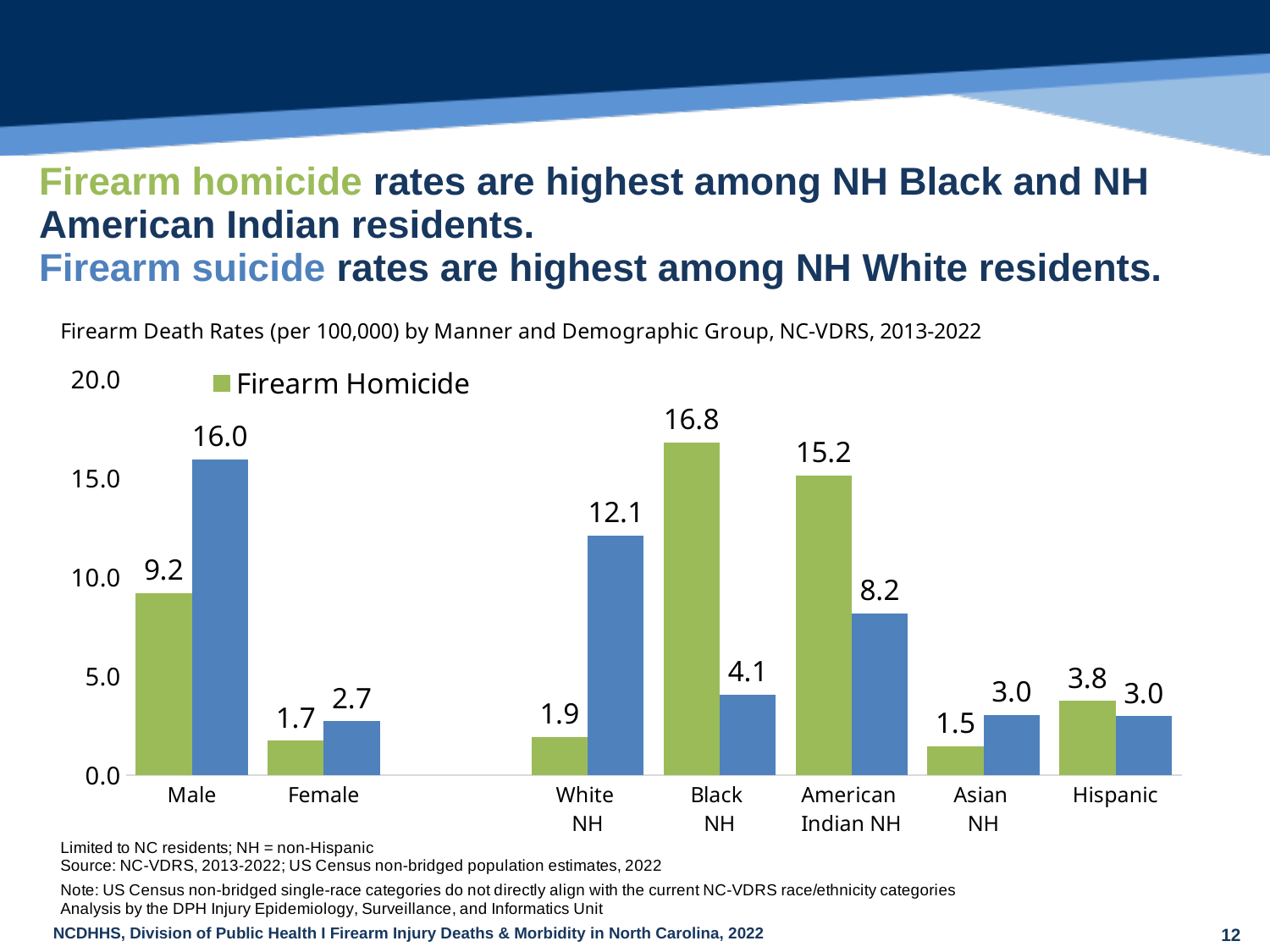
What is the firearm homicide rate for Black NH residents? 16.8 Which demographic group has the lowest firearm homicide rate? Asian NH What is the title of the chart? Firearm Death Rates (per 100,000) by Manner and Demographic Group, NC-VDRS, 2013-2022 How many demographic groups are shown on the x axis? 7 What is the value of the blue bar for Male? 16.0 Which is larger for Hispanic residents, the green bar or the blue bar? The green bar (3.8) What series name is shown in the chart legend? Firearm Homicide What is the firearm homicide rate for Female? 1.7 What kind of chart is shown on the slide? Bar chart Which demographic group has the highest firearm homicide rate? Black NH What is the difference between the firearm homicide rate for Black NH and American Indian NH residents? 1.6 What is the value of the blue bar for White NH? 12.1